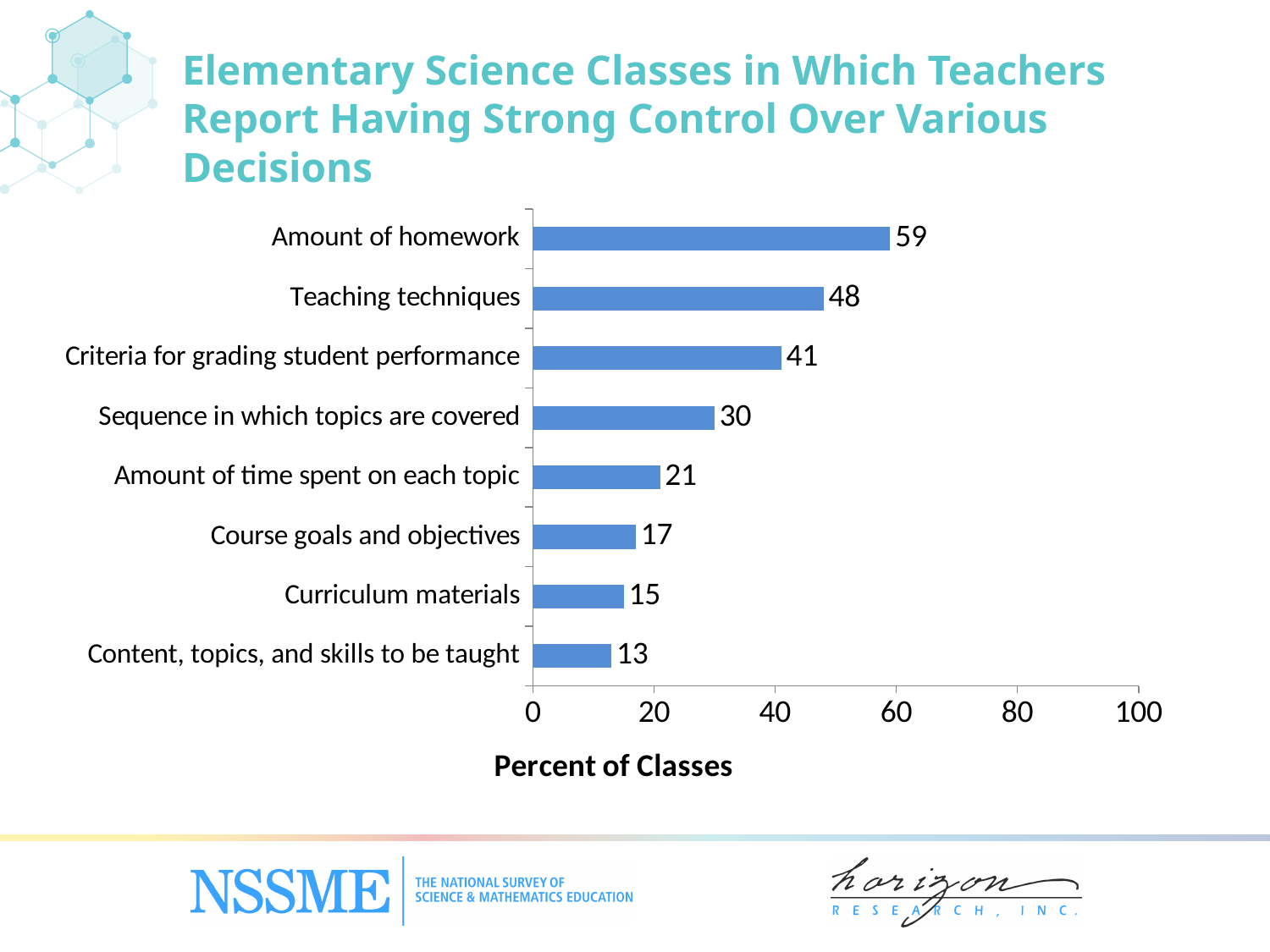
Which decision has the highest percent of classes? Amount of homework What kind of chart is shown on the slide? Bar chart Which is larger: the value for Amount of time spent on each topic or Course goals and objectives? Amount of time spent on each topic How many decision categories are shown in the chart? 8 Which decision has the lowest percent of classes? Content, topics, and skills to be taught What is the value for Sequence in which topics are covered? 30 What is the difference between the values for Teaching techniques and Criteria for grading student performance? 7 What is the label of the horizontal axis? Percent of Classes What is the difference between the values for Amount of homework and Content, topics, and skills to be taught? 46 Is the value for Teaching techniques greater or less than 40? greater What percent of classes is shown for Amount of homework? 59 What is the value for Curriculum materials? 15